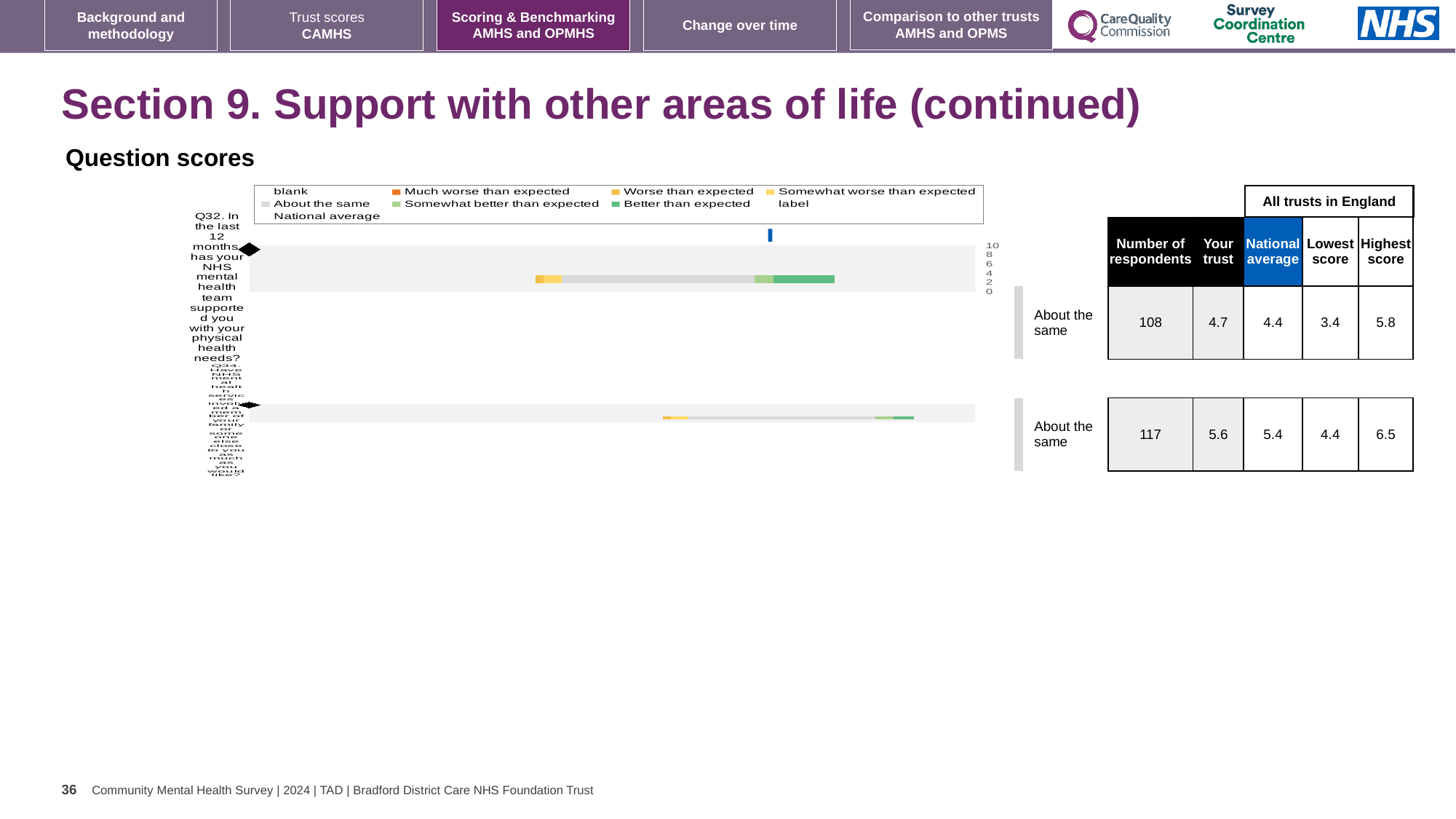
What kind of chart is shown under 'Question scores'? bar chart In the table beside the chart, what is the number of respondents for Q32? 108 In the table beside the chart, which question has the larger 'Your trust' score, Q32 or Q34? Q34 In the table beside the chart, what is the national average for Q34? 5.4 What colour does the legend use for 'Better than expected'? green Which question numbers are plotted in the chart? Q32 and Q34 How many questions (categories) are plotted in the chart? 2 How many entries does the chart legend list? 9 In the table beside the chart, what is the difference between the 'Your trust' score and the national average for Q32? 0.3 In the table beside the chart, what is the highest score for Q34? 6.5 In the table beside the chart, what is the 'Your trust' score for Q32? 4.7 In the table beside the chart, what is the lowest score for Q32? 3.4